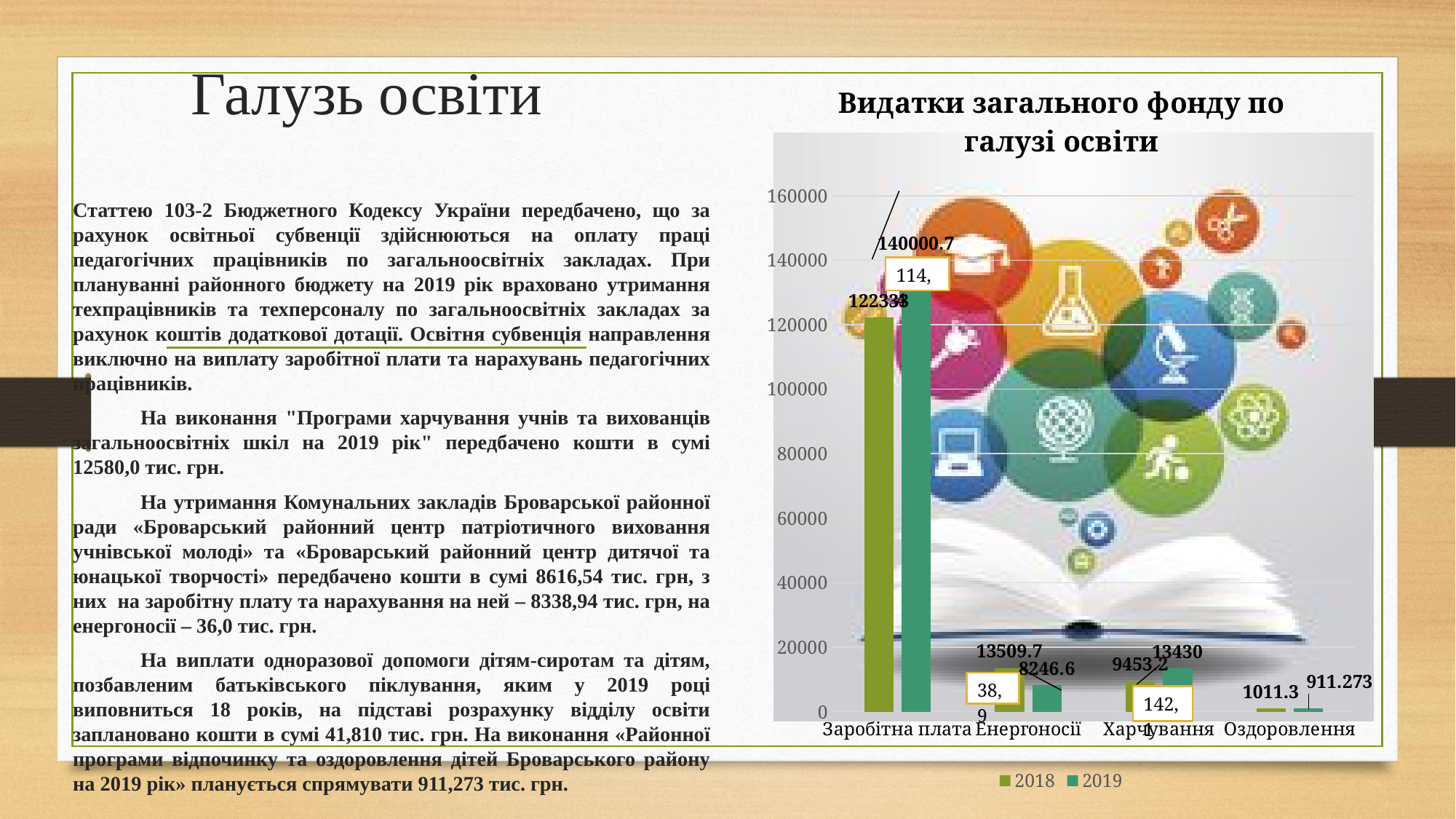
What is the difference between the 2019 and 2018 values for Харчування? 3976.8 What is the 2018 value for Оздоровлення in the chart? 1011.3 What is the 2019 value for Оздоровлення in the chart? 911.273 For Енергоносії, which year has the larger value, 2018 or 2019? 2018 What is the 2019 value for Харчування in the chart? 13430 How many categories are shown on the x axis of the chart? 4 Which category has the highest 2019 value in the chart? Заробітна плата What is the 2018 value for Енергоносії in the chart? 13509.7 What is the 2019 value for Заробітна плата in the chart? 140000.7 Which category has the lowest 2018 value in the chart? Оздоровлення How many series does the legend of the chart list? 2 What kind of chart is shown under the title "Видатки загального фонду по галузі освіти"? bar chart